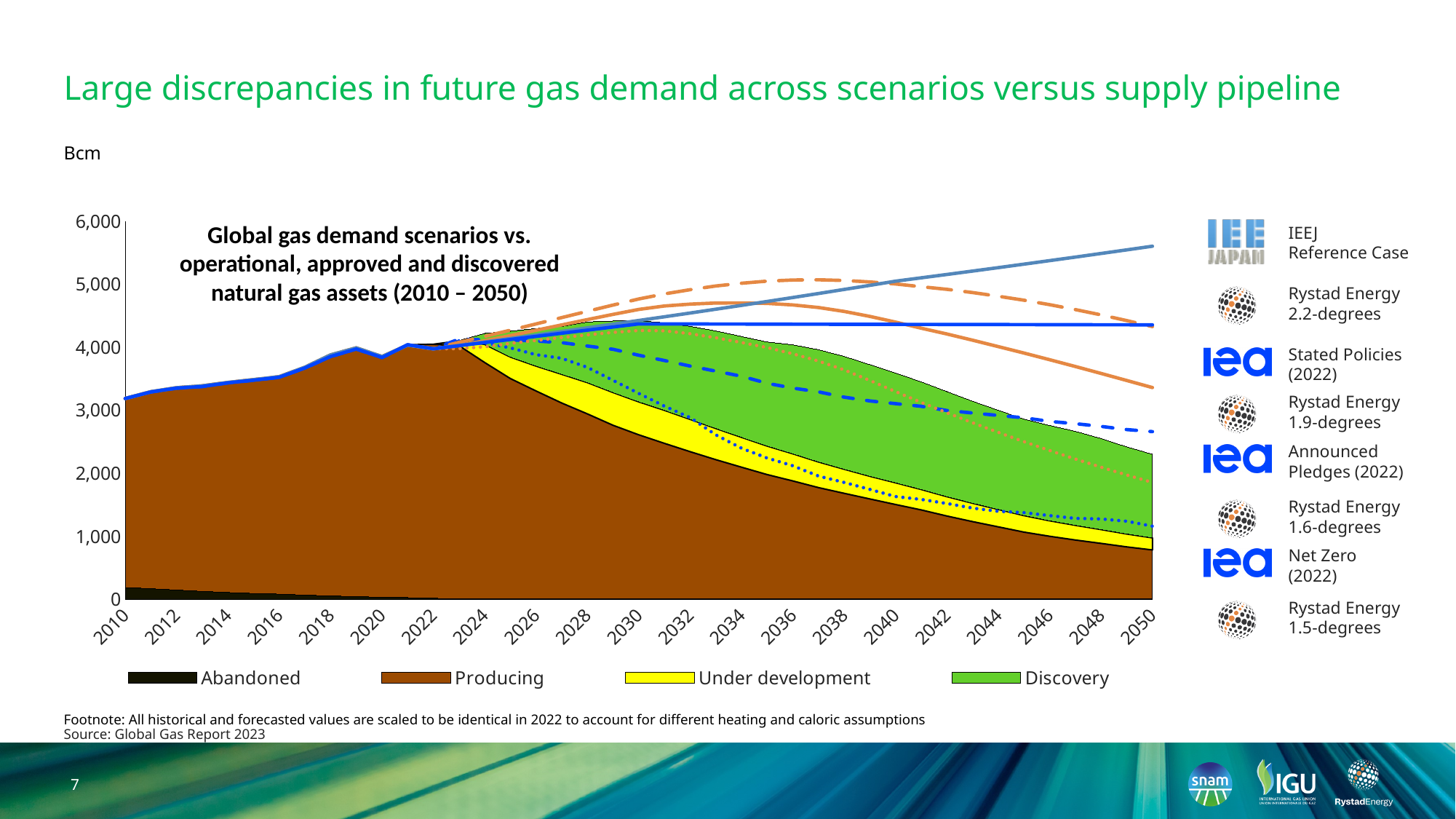
Which demand scenario has the lowest value in 2050? Net Zero (2022) Does the IEEJ Reference Case line rise or fall between 2022 and 2050? Rises What kind of chart is shown on the slide? Combination area and line chart What is the title of the chart? Global gas demand scenarios vs. operational, approved and discovered natural gas assets (2010 – 2050) How many asset categories does the legend below the chart list? 4 What unit is the y-axis measured in? Bcm How many demand scenarios are listed to the right of the chart? 8 Is the value of the Net Zero (2022) scenario in 2050 greater or less than 2,000? less In 2050, which is higher: the Stated Policies (2022) scenario or the Announced Pledges (2022) scenario? Stated Policies (2022) Is the value of the IEEJ Reference Case in 2050 greater or less than 5,000? greater Is the value of the Announced Pledges (2022) scenario in 2050 greater or less than 3,000? less Which demand scenario has the highest value in 2050? IEEJ Reference Case